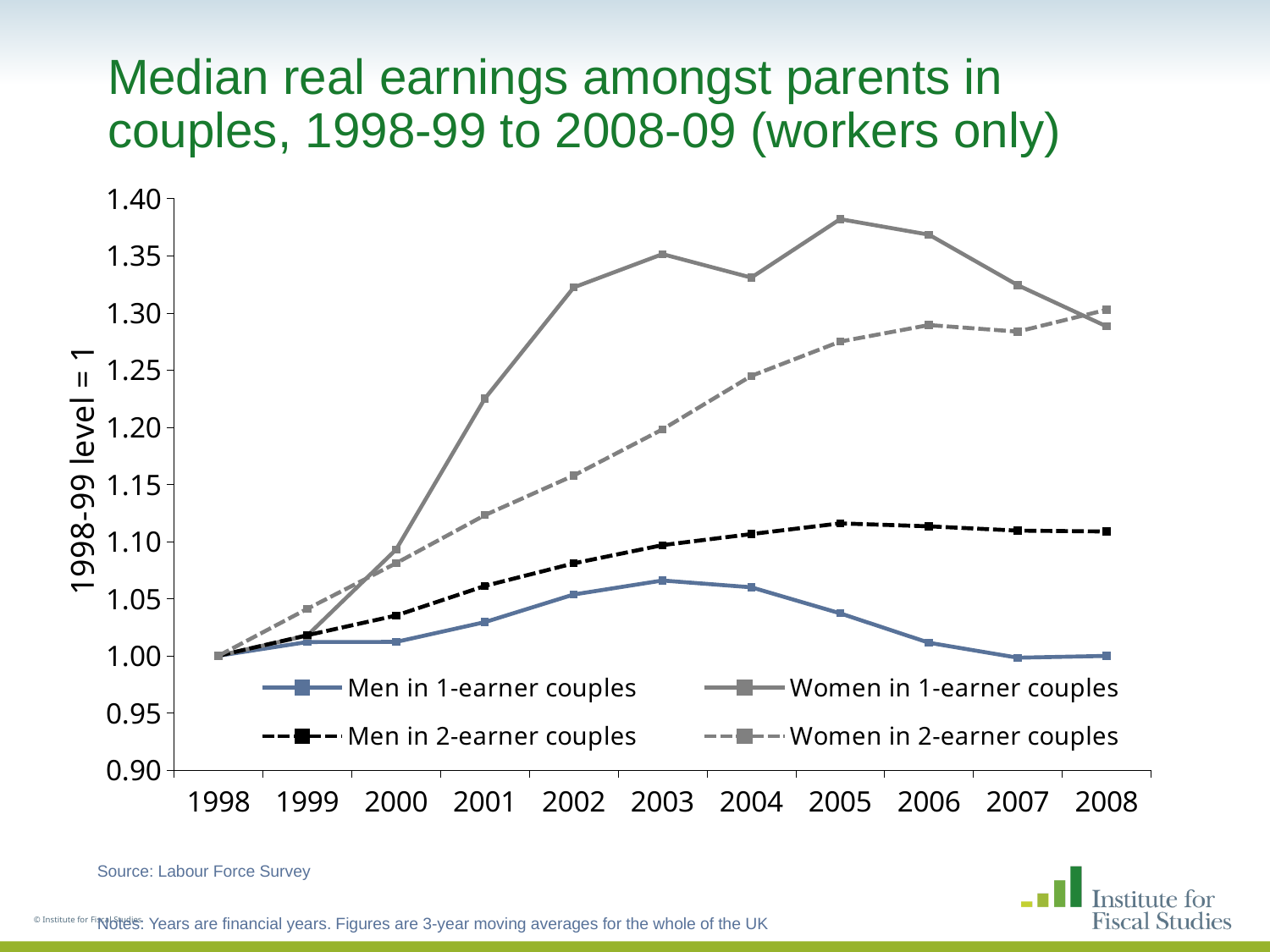
In which year does the Women in 1-earner couples series reach its highest value? 2005 Is the value for Men in 1-earner couples in 2007 greater or less than 1.05? less How many years are shown along the x axis? 11 In 2006, which is larger: the value for Men in 2-earner couples or Men in 1-earner couples? Men in 2-earner couples How many series does the legend list? 4 What is the value for Men in 1-earner couples in 1998? 1.00 Do the values for Men in 1-earner couples rise or fall from 2003 to 2007? fall Which series has the highest value in 2005? Women in 1-earner couples Is the value for Women in 2-earner couples in 2006 greater or less than 1.25? greater What kind of chart is shown on the slide? line chart Which series has the lowest value in 2008? Men in 1-earner couples Is the value for Women in 1-earner couples in 2005 greater or less than 1.35? greater